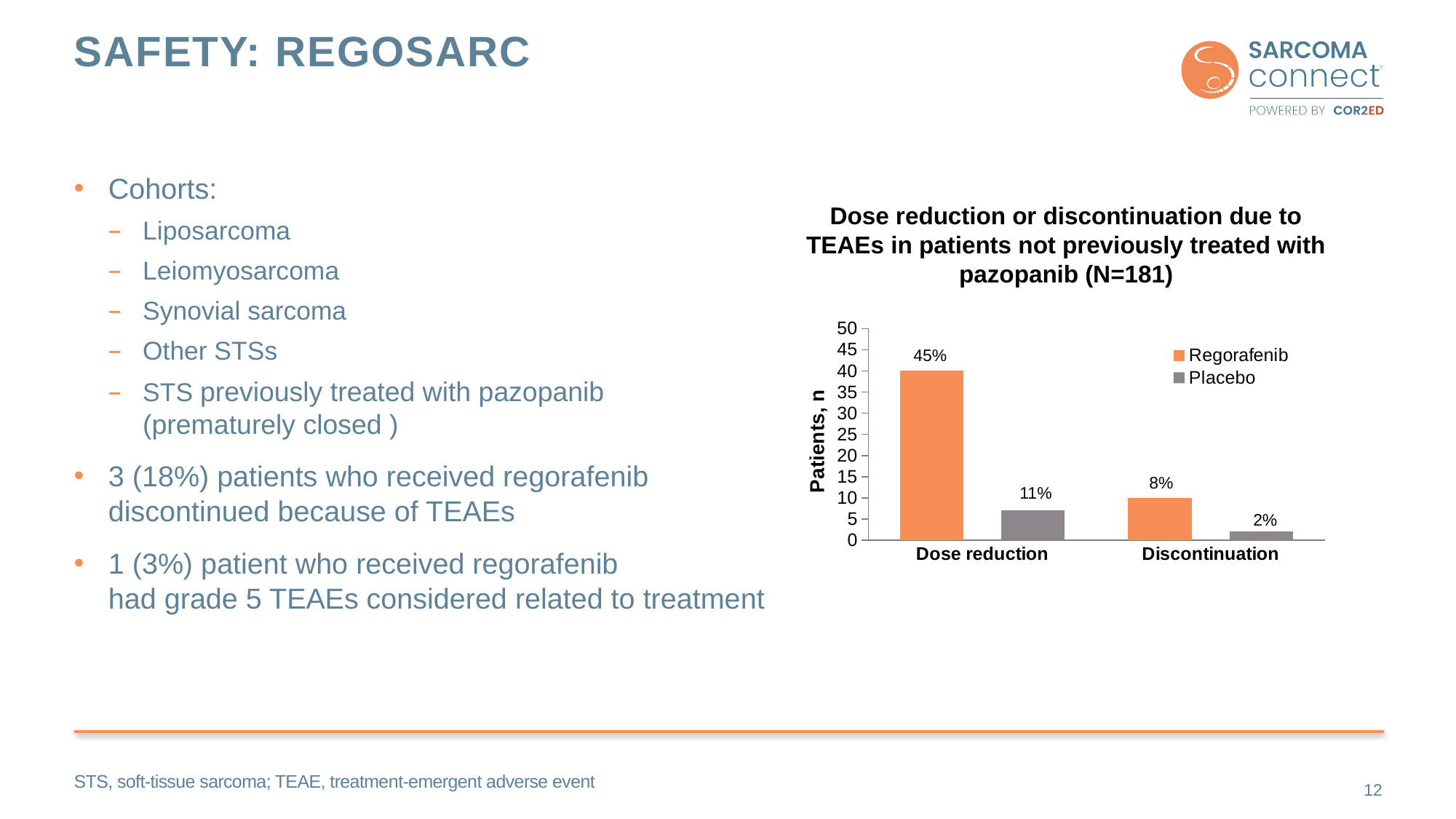
Is the number of patients for Regorafenib in the Dose reduction category greater or less than 30? greater What is the data label for Regorafenib in the Discontinuation category? 8% What is the data label for Placebo in the Dose reduction category? 11% Which bar has the highest value in the chart? Regorafenib, Dose reduction What kind of chart is shown on the slide? Bar chart How many series does the legend list? 2 For Discontinuation, which series has the larger value, Regorafenib or Placebo? Regorafenib What is the label of the y axis? Patients, n Which bar has the lowest value in the chart? Placebo, Discontinuation What is the data label for Placebo in the Discontinuation category? 2% What is the data label for Regorafenib in the Dose reduction category? 45% What is the difference between the Regorafenib and Placebo percentage labels for Dose reduction? 34%